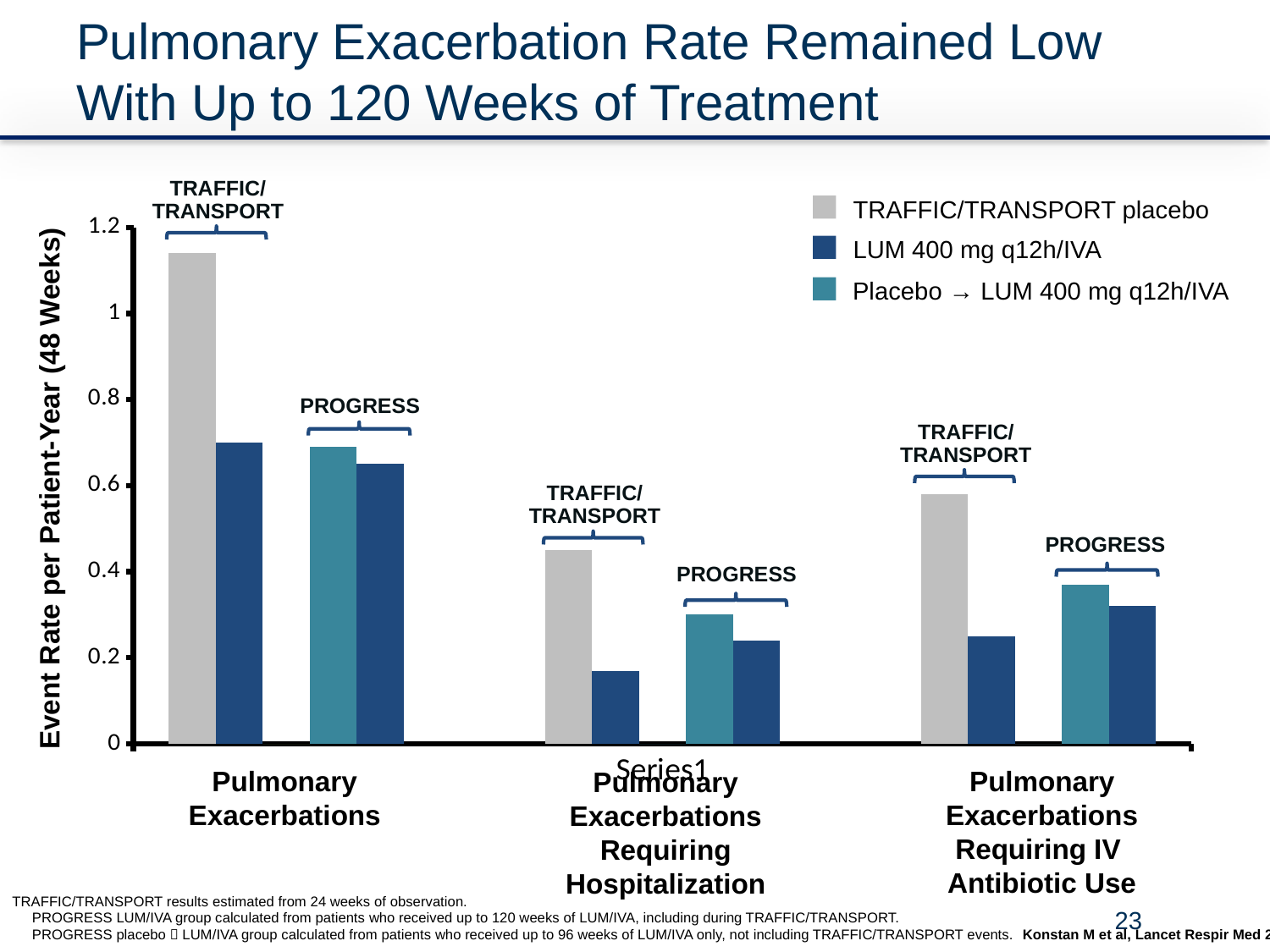
Is the TRAFFIC/TRANSPORT placebo value for Pulmonary Exacerbations greater or less than 1? greater How many outcome categories are shown along the x axis? 3 What kind of chart is shown on the slide? bar chart How many series does the legend list? 3 Which is larger: the TRAFFIC/TRANSPORT placebo bar for Pulmonary Exacerbations Requiring Hospitalization or the TRAFFIC/TRANSPORT placebo bar for Pulmonary Exacerbations Requiring IV Antibiotic Use? Pulmonary Exacerbations Requiring IV Antibiotic Use What is the title of the y axis? Event Rate per Patient-Year (48 Weeks) In the TRAFFIC/TRANSPORT group for Pulmonary Exacerbations, which is larger: the placebo bar or the LUM 400 mg q12h/IVA bar? placebo Is the TRAFFIC/TRANSPORT placebo value for Pulmonary Exacerbations Requiring IV Antibiotic Use greater or less than 0.4? greater Which bar is the tallest in the chart? TRAFFIC/TRANSPORT placebo for Pulmonary Exacerbations Which bar is the lowest in the chart? LUM 400 mg q12h/IVA (TRAFFIC/TRANSPORT) for Pulmonary Exacerbations Requiring Hospitalization Is the PROGRESS Placebo → LUM 400 mg q12h/IVA value for Pulmonary Exacerbations Requiring Hospitalization greater or less than 0.2? greater